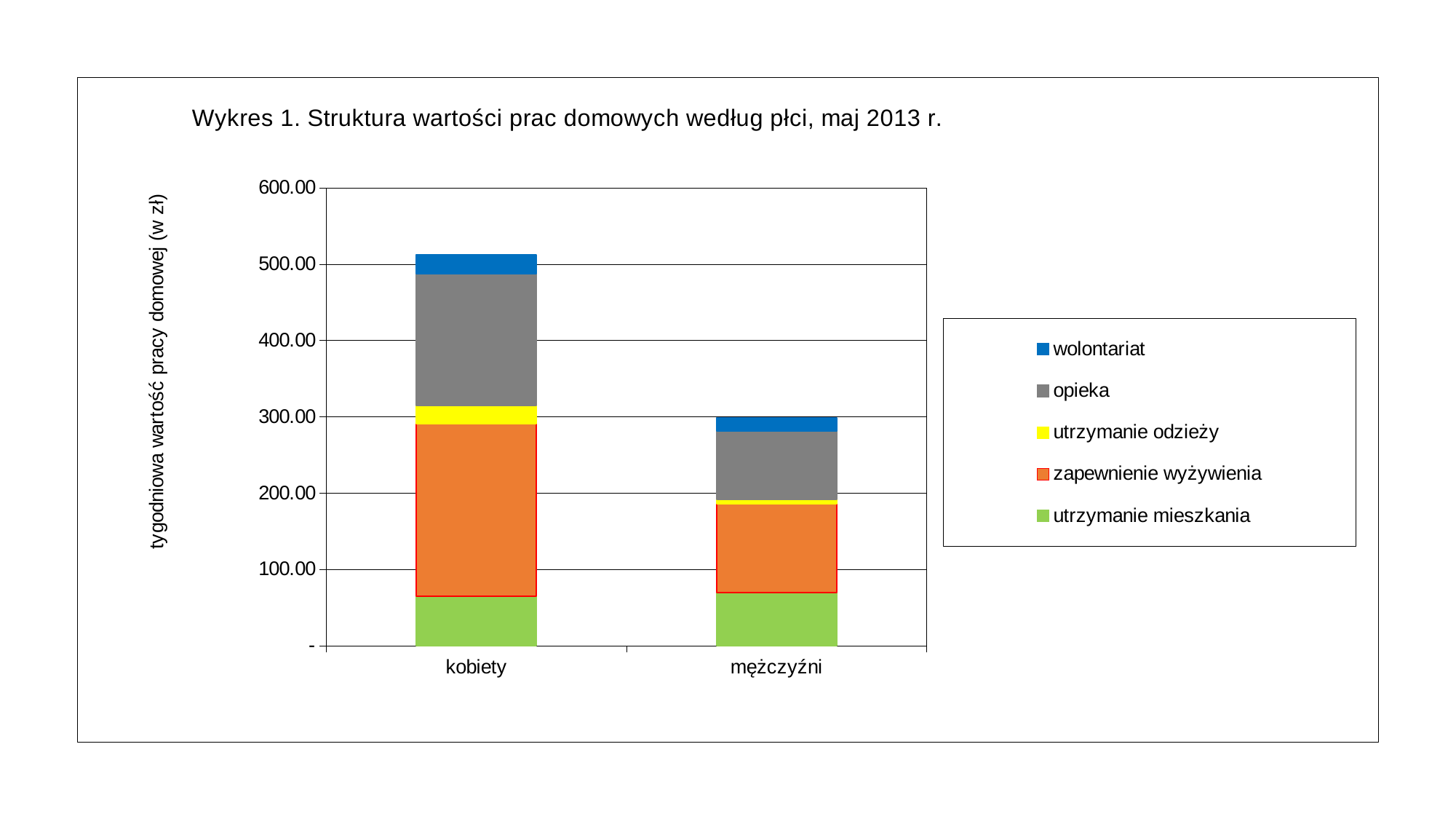
What is the title of the chart? Wykres 1. Struktura wartości prac domowych według płci, maj 2013 r. Is the total value for mężczyźni greater or less than 400? less What is the label of the y axis? tygodniowa wartość pracy domowej (w zł) Which series is shown in orange in the legend? zapewnienie wyżywienia How many categories are shown on the x axis? 2 Is the total value for kobiety greater or less than 400? greater Do the total bar values rise or fall from kobiety to mężczyźni? fall What kind of chart is shown on the slide? bar chart How many series does the legend list? 5 Which category has the lowest total bar? mężczyźni Which category has the higher total bar, kobiety or mężczyźni? kobiety